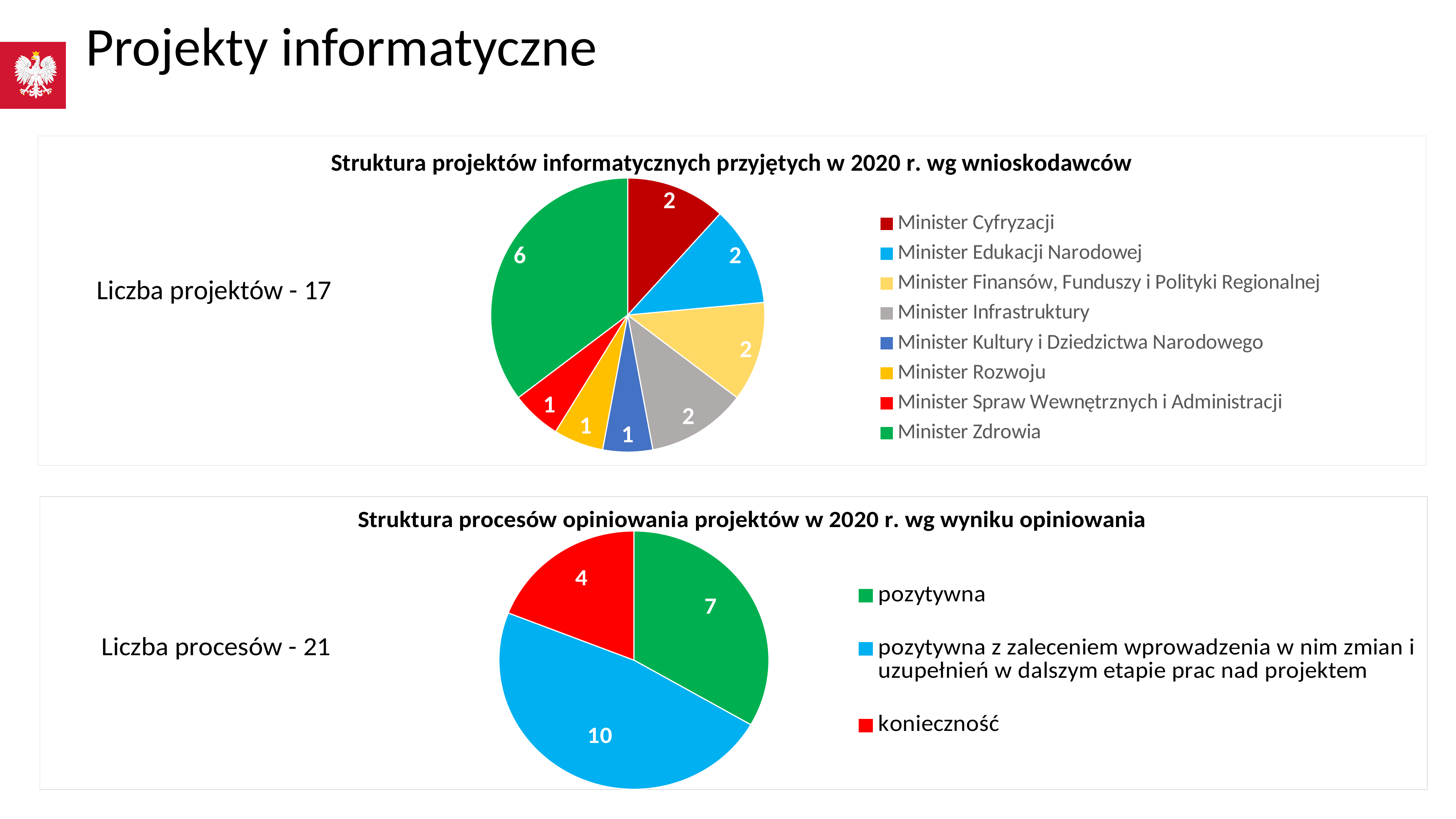
In the bottom chart 'Struktura procesów opiniowania projektów w 2020 r. wg wyniku opiniowania', what is the value for 'pozytywna'? 7 In the top chart 'Struktura projektów informatycznych przyjętych w 2020 r. wg wnioskodawców', what is the value for Minister Zdrowia? 6 In the bottom chart 'Struktura procesów opiniowania projektów w 2020 r. wg wyniku opiniowania', what colour is the slice for 'pozytywna'? Green In the top chart 'Struktura projektów informatycznych przyjętych w 2020 r. wg wnioskodawców', how many categories does the legend list? 8 In the bottom chart 'Struktura procesów opiniowania projektów w 2020 r. wg wyniku opiniowania', what is the value for 'konieczność'? 4 In the top chart 'Struktura projektów informatycznych przyjętych w 2020 r. wg wnioskodawców', which is larger: the value for Minister Edukacji Narodowej or Minister Rozwoju? Minister Edukacji Narodowej What kind of chart is the top chart 'Struktura projektów informatycznych przyjętych w 2020 r. wg wnioskodawców'? Pie chart In the top chart 'Struktura projektów informatycznych przyjętych w 2020 r. wg wnioskodawców', which category has the largest slice? Minister Zdrowia In the top chart 'Struktura projektów informatycznych przyjętych w 2020 r. wg wnioskodawców', what is the difference between the values for Minister Zdrowia and Minister Cyfryzacji? 4 In the bottom chart 'Struktura procesów opiniowania projektów w 2020 r. wg wyniku opiniowania', what is the difference between the largest and smallest slice values? 6 In the top chart 'Struktura projektów informatycznych przyjętych w 2020 r. wg wnioskodawców', what is the value for Minister Infrastruktury? 2 In the bottom chart 'Struktura procesów opiniowania projektów w 2020 r. wg wyniku opiniowania', which category has the smallest slice? konieczność